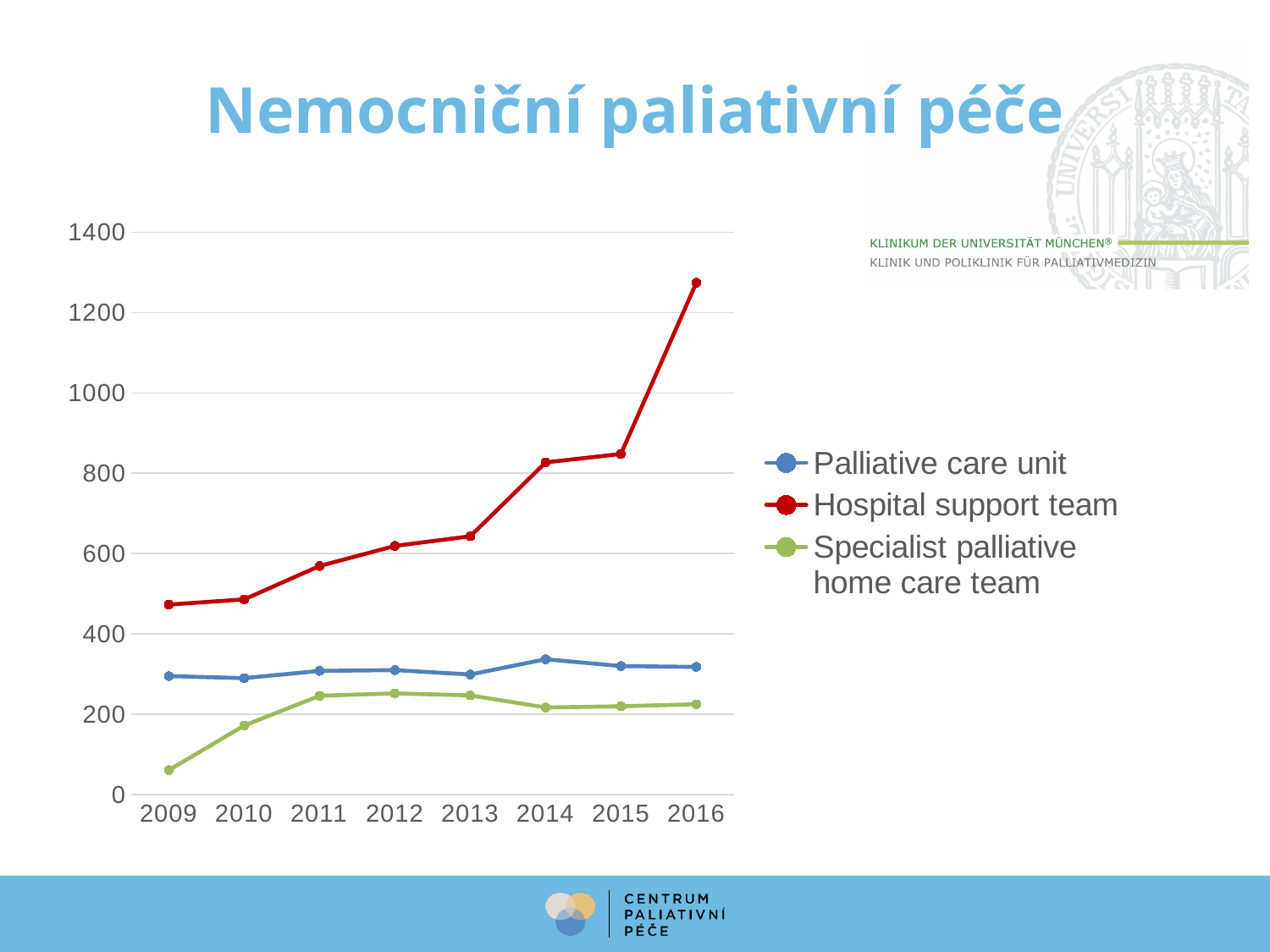
Is the value for Palliative care unit in 2014 greater or less than 400? less What colour is the line for Hospital support team? red Is the value for Specialist palliative home care team in 2009 greater or less than 200? less Which is larger in 2012: Palliative care unit or Specialist palliative home care team? Palliative care unit Which series has the highest value in 2016? Hospital support team How many years are plotted along the x axis? 8 In which year is the Specialist palliative home care team value lowest? 2009 In which year does the Hospital support team series reach its highest value? 2016 How many series does the legend list? 3 Does the Hospital support team series generally rise or fall from 2009 to 2016? rise Is the value for Hospital support team in 2016 greater or less than 1200? greater What kind of chart is shown on the slide? line chart